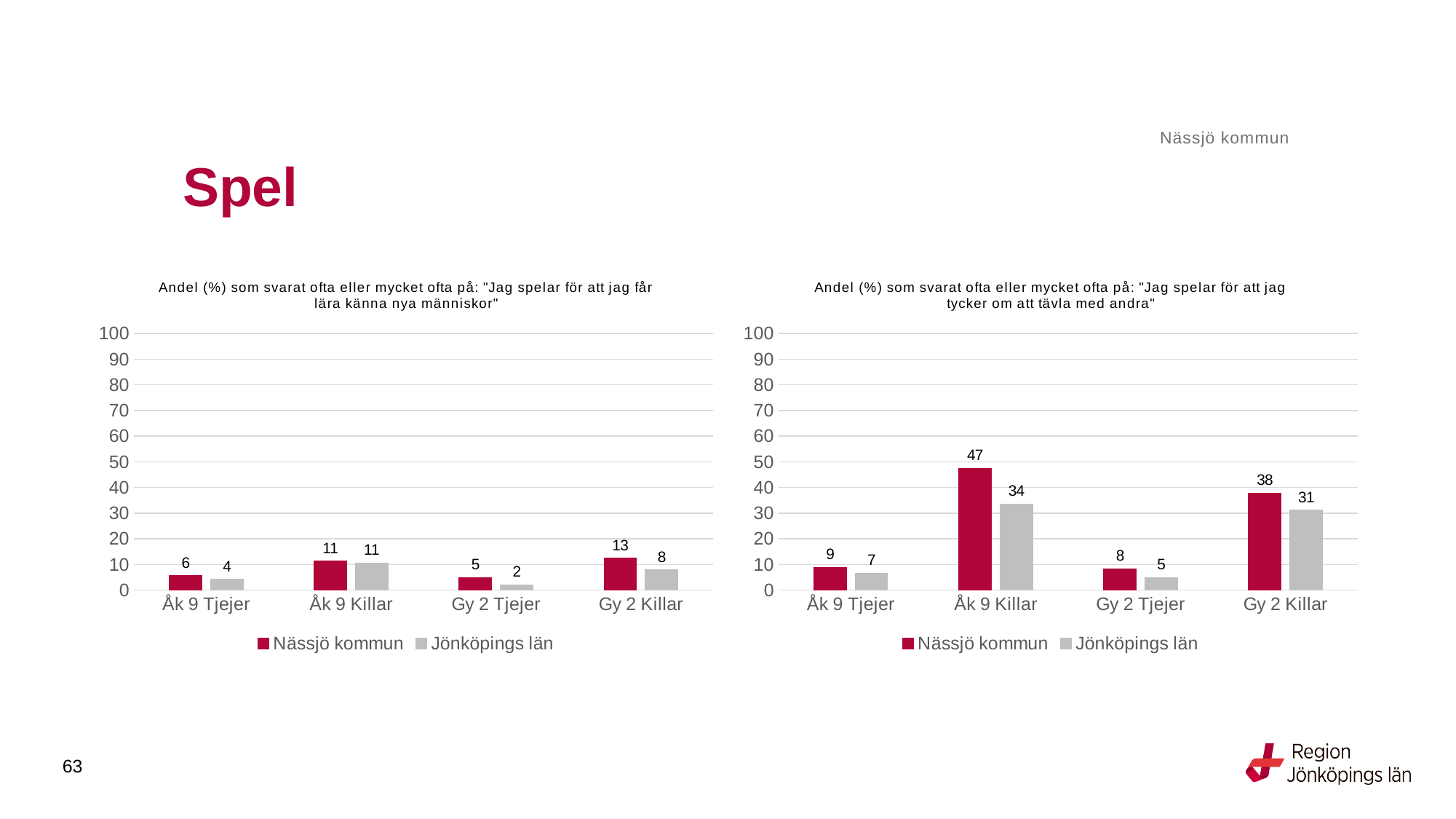
What kind of chart is the left chart ("Jag spelar för att jag får lära känna nya människor")? Bar chart In the right chart ("Jag spelar för att jag tycker om att tävla med andra"), what is the value for Jönköpings län for Gy 2 Killar? 31 In the left chart ("Jag spelar för att jag får lära känna nya människor"), what is the value for Nässjö kommun for Gy 2 Killar? 13 In the right chart ("Jag spelar för att jag tycker om att tävla med andra"), is the value for Nässjö kommun for Gy 2 Killar greater or less than 30? greater In the right chart ("Jag spelar för att jag tycker om att tävla med andra"), what is the difference between Nässjö kommun and Jönköpings län for Åk 9 Killar? 13 In the left chart ("Jag spelar för att jag får lära känna nya människor"), which is larger for Gy 2 Killar: Nässjö kommun or Jönköpings län? Nässjö kommun In the left chart ("Jag spelar för att jag får lära känna nya människor"), what is the value for Jönköpings län for Gy 2 Tjejer? 2 How many series does the legend of the right chart ("Jag spelar för att jag tycker om att tävla med andra") list? 2 How many categories are shown on the x axis of the left chart ("Jag spelar för att jag får lära känna nya människor")? 4 In the right chart ("Jag spelar för att jag tycker om att tävla med andra"), which category has the highest value for Nässjö kommun? Åk 9 Killar In the right chart ("Jag spelar för att jag tycker om att tävla med andra"), what is the value for Nässjö kommun for Åk 9 Killar? 47 In the left chart ("Jag spelar för att jag får lära känna nya människor"), which category has the lowest value for Jönköpings län? Gy 2 Tjejer